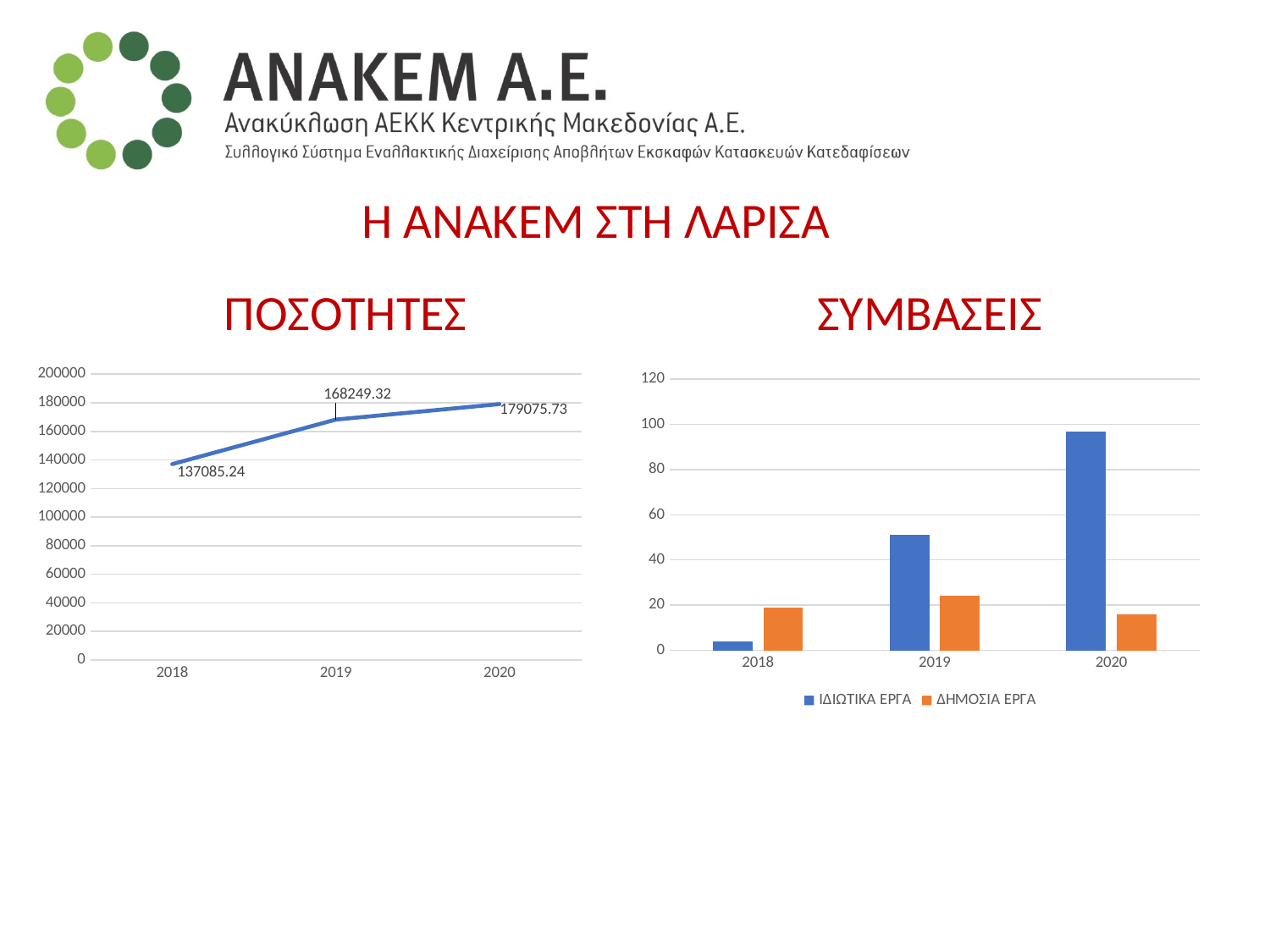
In the ΠΟΣΟΤΗΤΕΣ chart, what is the value for 2018? 137085.24 In the ΠΟΣΟΤΗΤΕΣ chart, what is the value for 2020? 179075.73 In the ΣΥΜΒΑΣΕΙΣ chart, which series is larger in 2018, ΙΔΙΩΤΙΚΑ ΕΡΓΑ or ΔΗΜΟΣΙΑ ΕΡΓΑ? ΔΗΜΟΣΙΑ ΕΡΓΑ In the ΣΥΜΒΑΣΕΙΣ chart, which year has the highest value for ΙΔΙΩΤΙΚΑ ΕΡΓΑ? 2020 What kind of chart is the ΠΟΣΟΤΗΤΕΣ chart? line chart In the ΠΟΣΟΤΗΤΕΣ chart, do the values rise or fall from 2018 to 2020? rise In the ΠΟΣΟΤΗΤΕΣ chart, which year has the highest value? 2020 What kind of chart is the ΣΥΜΒΑΣΕΙΣ chart? bar chart In the ΠΟΣΟΤΗΤΕΣ chart, what is the difference between the 2019 and 2018 values? 31164.08 In the ΣΥΜΒΑΣΕΙΣ chart, is the value for ΙΔΙΩΤΙΚΑ ΕΡΓΑ in 2020 greater or less than 80? greater In the ΠΟΣΟΤΗΤΕΣ chart, what is the value for 2019? 168249.32 How many series does the legend of the ΣΥΜΒΑΣΕΙΣ chart list? 2